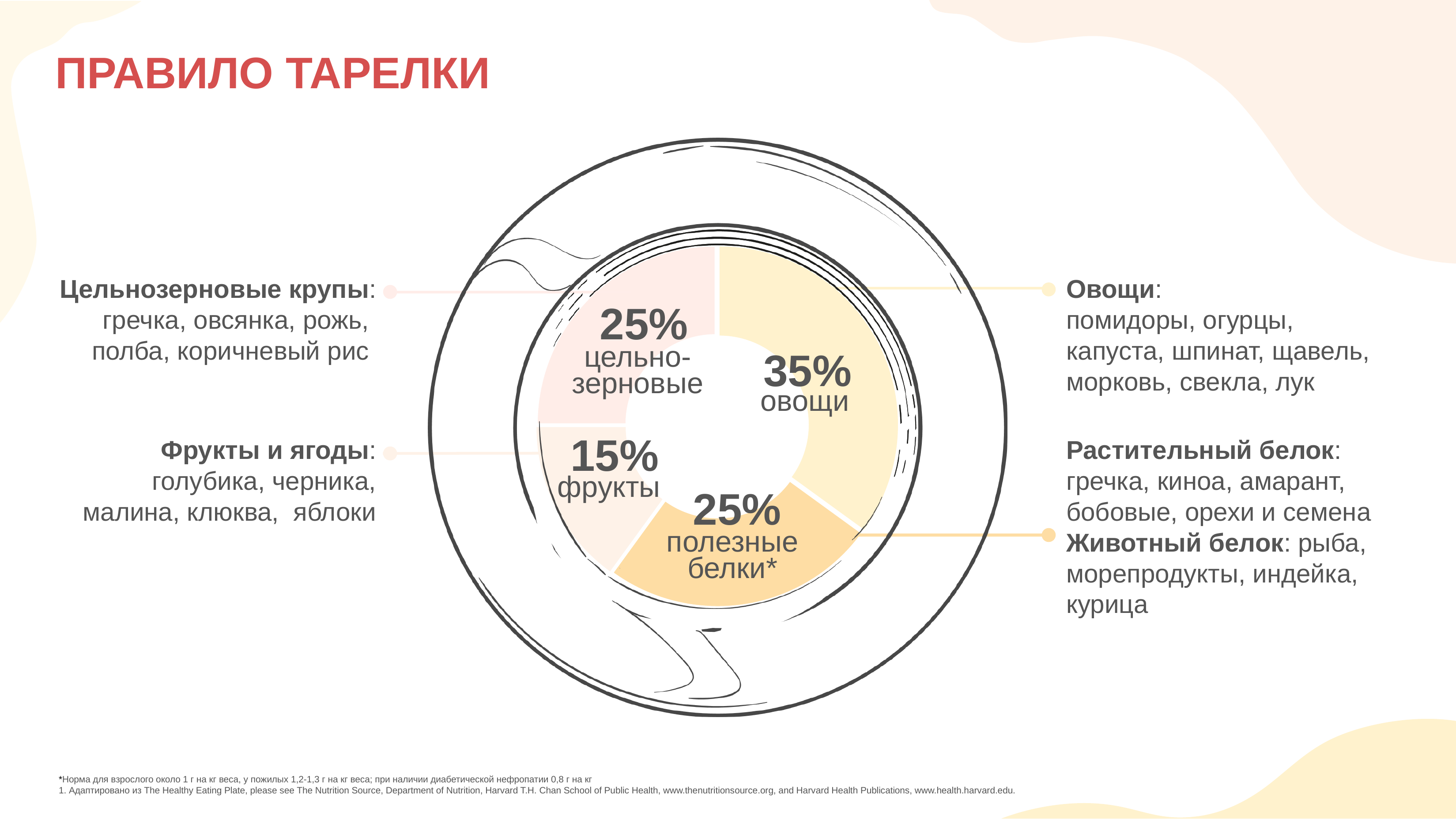
What is the combined share of цельнозерновые and фрукты? 40% What share of the plate is allocated to цельнозерновые (whole grains)? 25% What kind of chart is shown on the slide? pie chart (donut) Which segment of the plate chart has the smallest share? фрукты What is the difference in percentage points between the овощи segment and the фрукты segment? 20 What share of the plate is allocated to полезные белки (healthy proteins)? 25% Which is larger: the share for овощи or the share for полезные белки? овощи What share of the plate is allocated to овощи (vegetables)? 35% Which segment of the plate chart has the largest share? овощи What share of the plate is allocated to фрукты (fruits)? 15% What is the title of the slide containing the chart? ПРАВИЛО ТАРЕЛКИ How many segments does the plate chart have? 4